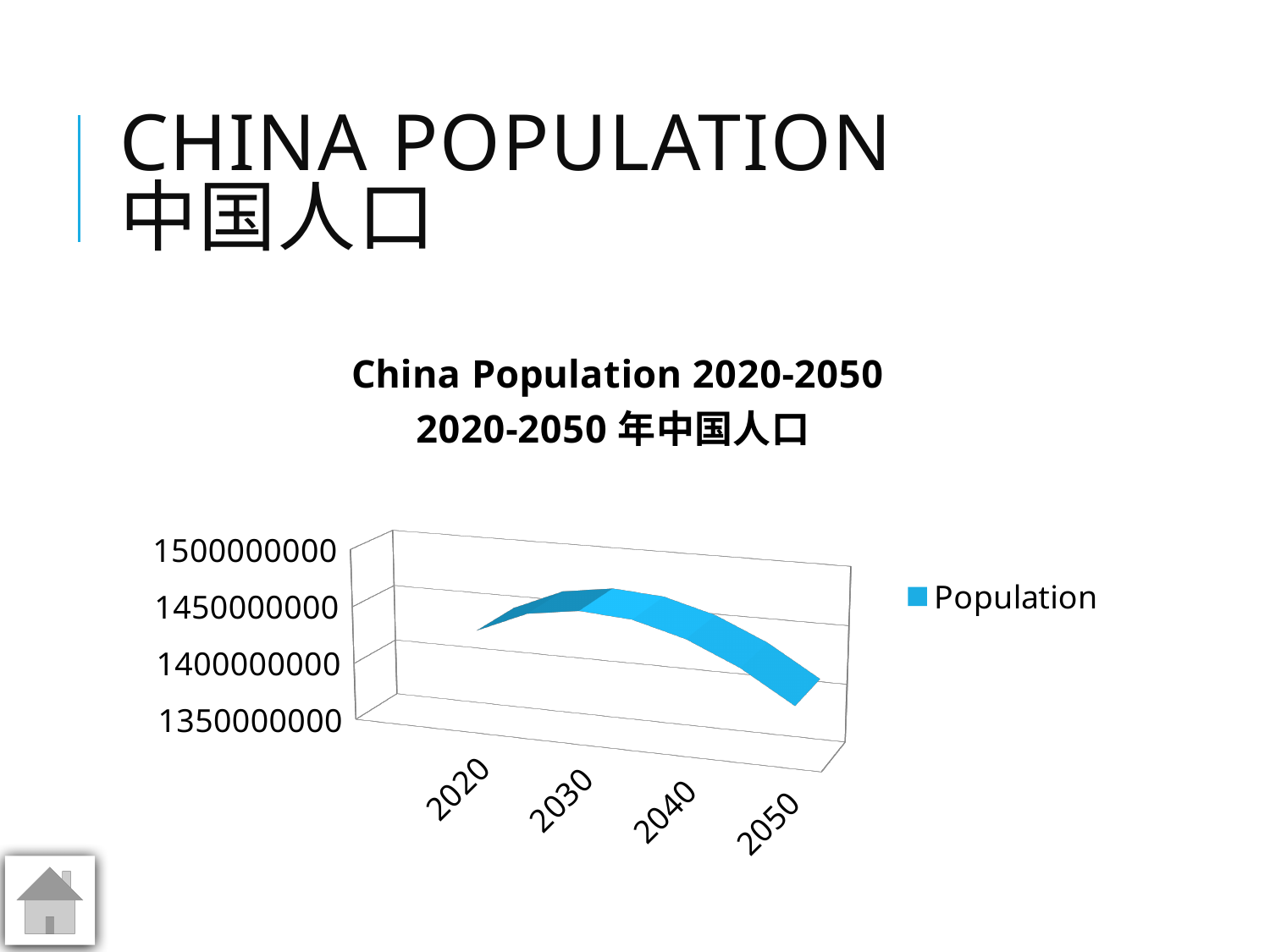
Which year has the lowest population value in the chart? 2050 Does the population value rise or fall between 2030 and 2050? fall What is the name of the series shown in the chart's legend? Population How many series does the chart's legend list? 1 What kind of chart is shown on the slide? Line chart Is the population value for 2050 greater or less than 1450000000? less Is the population value for 2030 greater or less than 1400000000? greater Which year has the highest population value in the chart? 2030 Does the population value rise or fall between 2020 and 2030? rise Which has the larger population value, 2030 or 2050? 2030 What is the English title of the chart? China Population 2020-2050